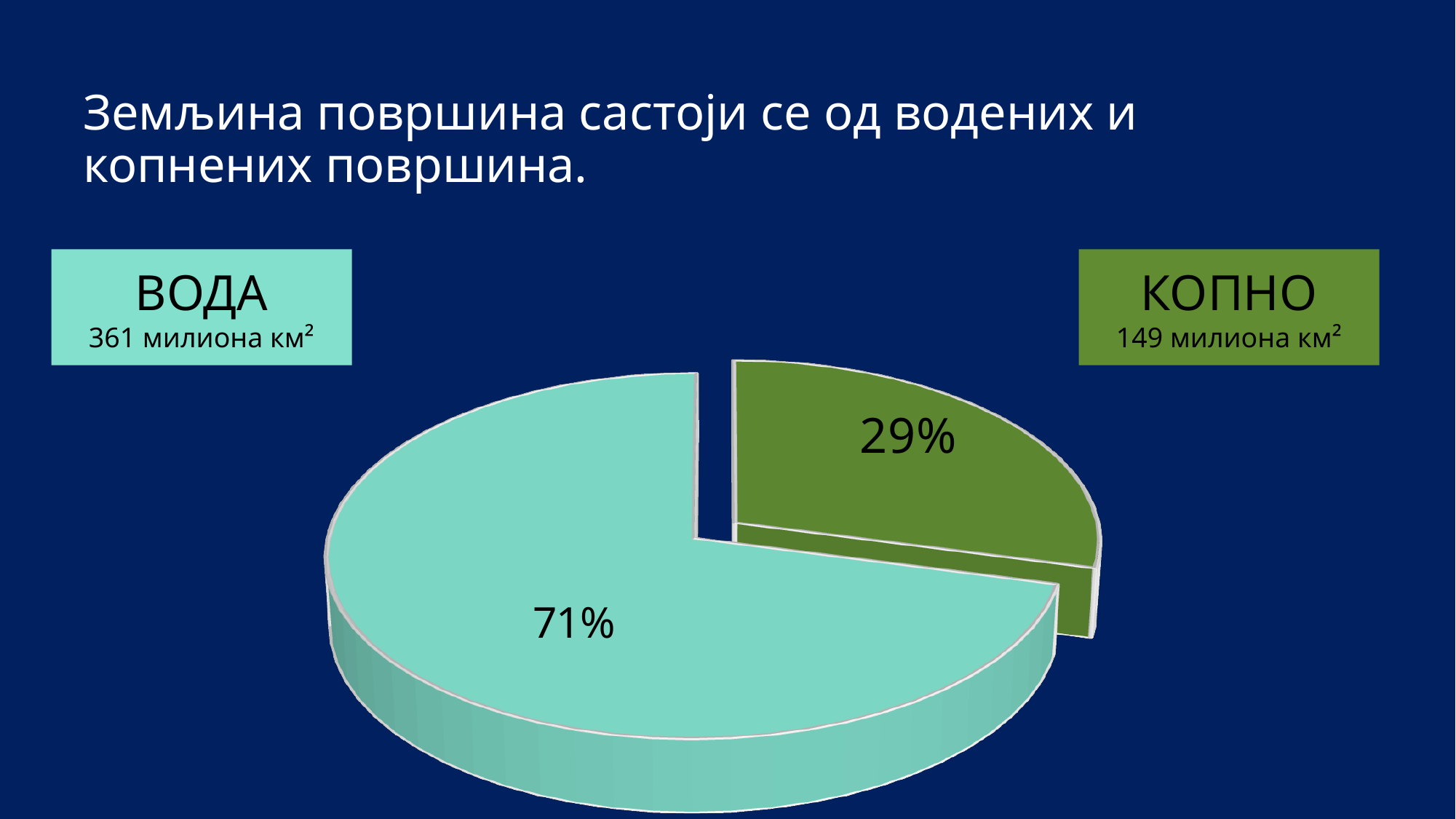
What kind of chart is shown on the slide? pie chart How many slices does the pie chart have? 2 What colour is the ВОДА slice of the pie? light teal Which slice of the pie is the smallest? КОПНО What percentage of the pie does the КОПНО (land) slice represent? 29% What colour is the КОПНО slice of the pie? green What area in million km² is given for КОПНО on the slide? 149 милиона км² What area in million km² is given for ВОДА on the slide? 361 милиона км² What is the difference in percentage points between the ВОДА slice and the КОПНО slice? 42 What percentage of the pie does the ВОДА (water) slice represent? 71% Which is larger, the ВОДА slice or the КОПНО slice? ВОДА Which slice of the pie is the largest? ВОДА